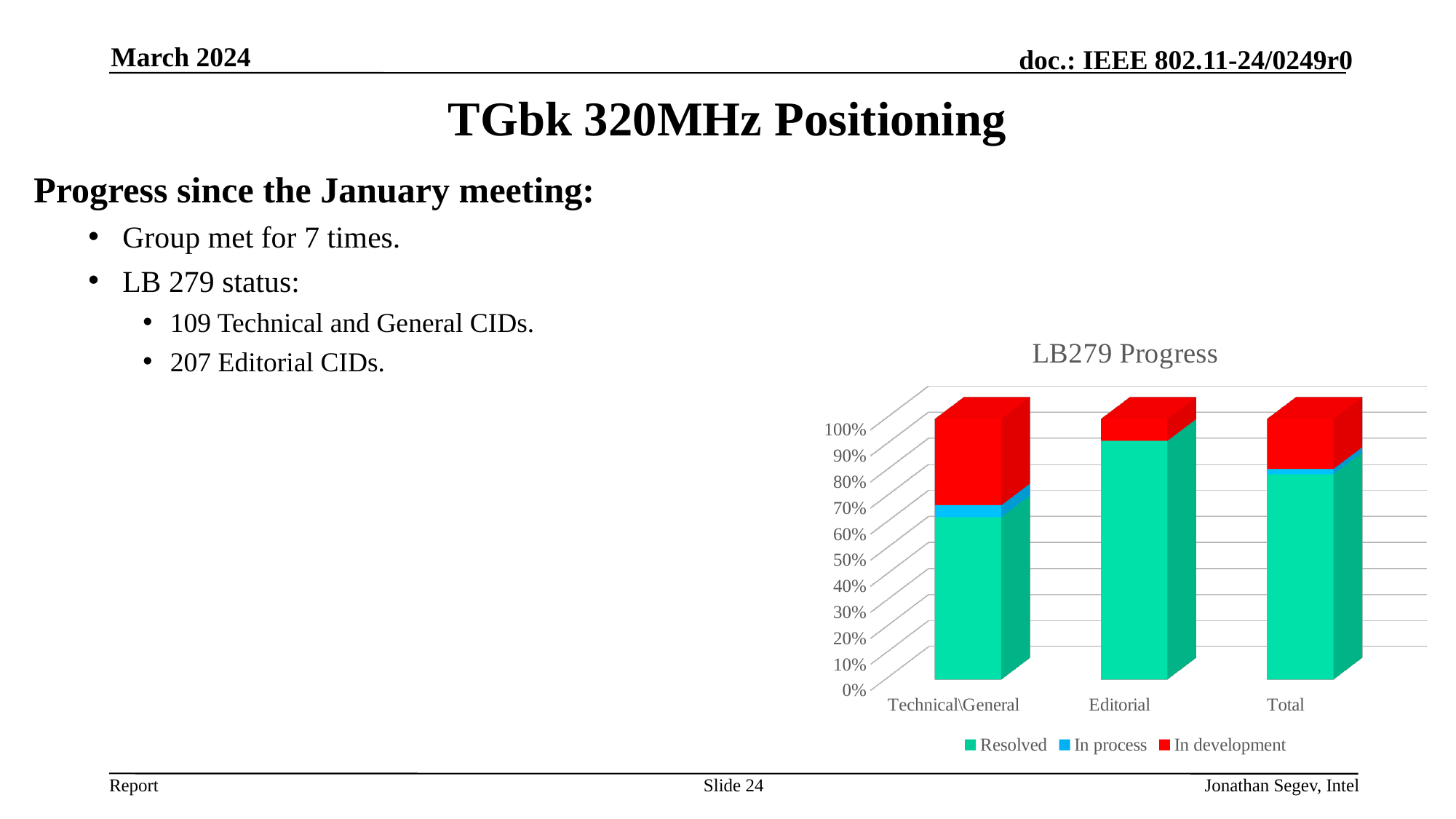
Is the Resolved share for Technical\General greater or less than 50%? greater Which category has the largest In development share in the LB279 Progress chart? Technical\General What is the title of the chart on the slide? LB279 Progress Is the Resolved share for Technical\General greater or less than 80%? less Is the Resolved share for Editorial greater or less than 80%? greater Which category has the highest Resolved share in the LB279 Progress chart? Editorial What kind of chart is shown on the slide? Stacked bar chart How many series does the legend of the LB279 Progress chart list? 3 How many categories are shown on the x axis of the LB279 Progress chart? 3 Which category has the lowest Resolved share in the LB279 Progress chart? Technical\General Which has a larger Resolved share, Editorial or Technical\General? Editorial Which series in the LB279 Progress chart is shown in red? In development